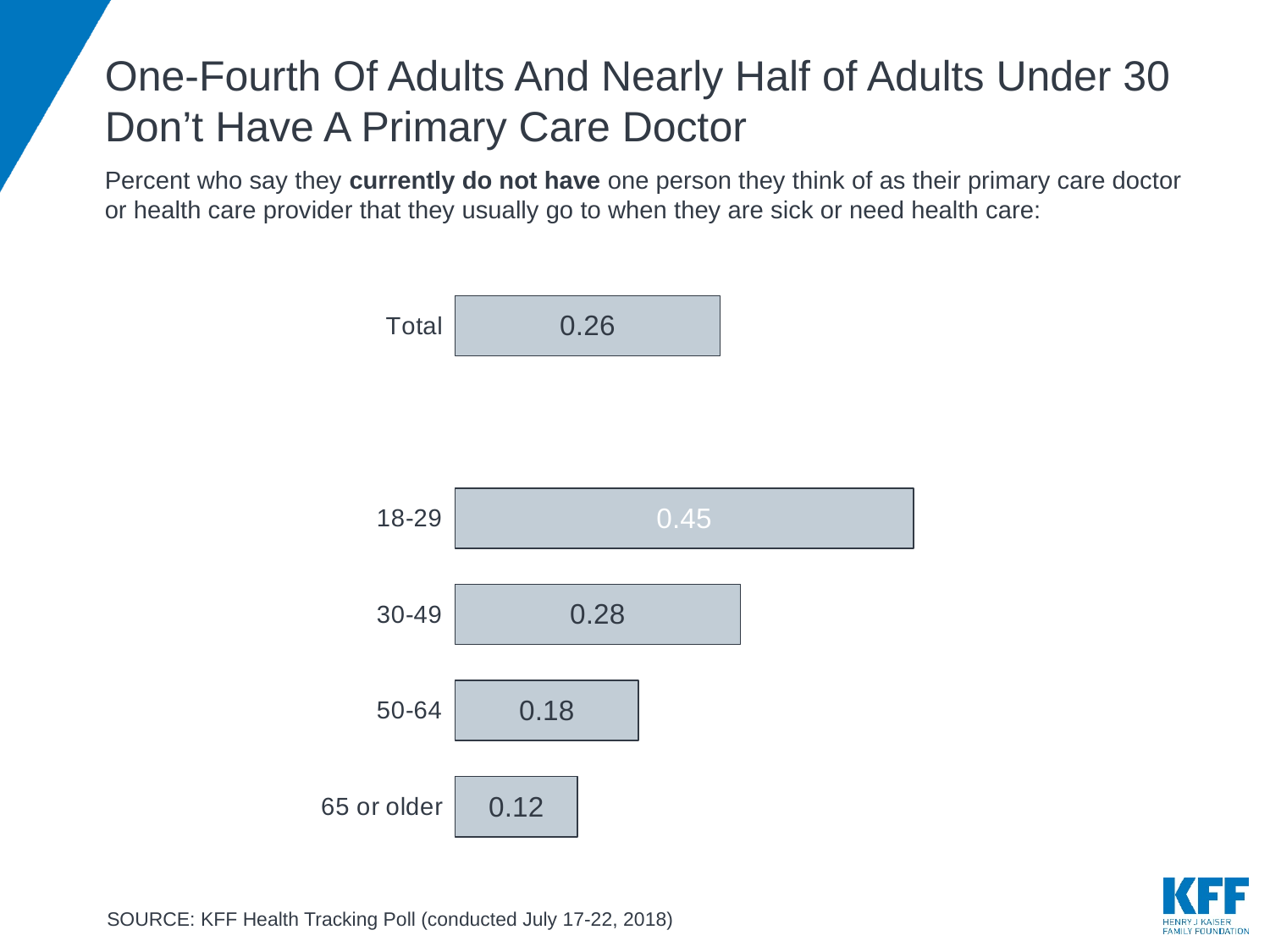
What is the value for the 30-49 age group? 0.28 Which age group has the highest value? 18-29 What is the difference between the values for 18-29 and 65 or older? 0.33 What is the value for the Total bar? 0.26 What is the difference between the values for 30-49 and 50-64? 0.10 How many bars are shown in the chart? 5 What is the value for the 18-29 age group? 0.45 Which category has the lowest value? 65 or older What is the value for the 65 or older age group? 0.12 Do the values rise or fall as the age groups get older, from 18-29 to 65 or older? Fall Which is larger, the value for 30-49 or the value for Total? 30-49 What kind of chart is shown on the slide? Bar chart